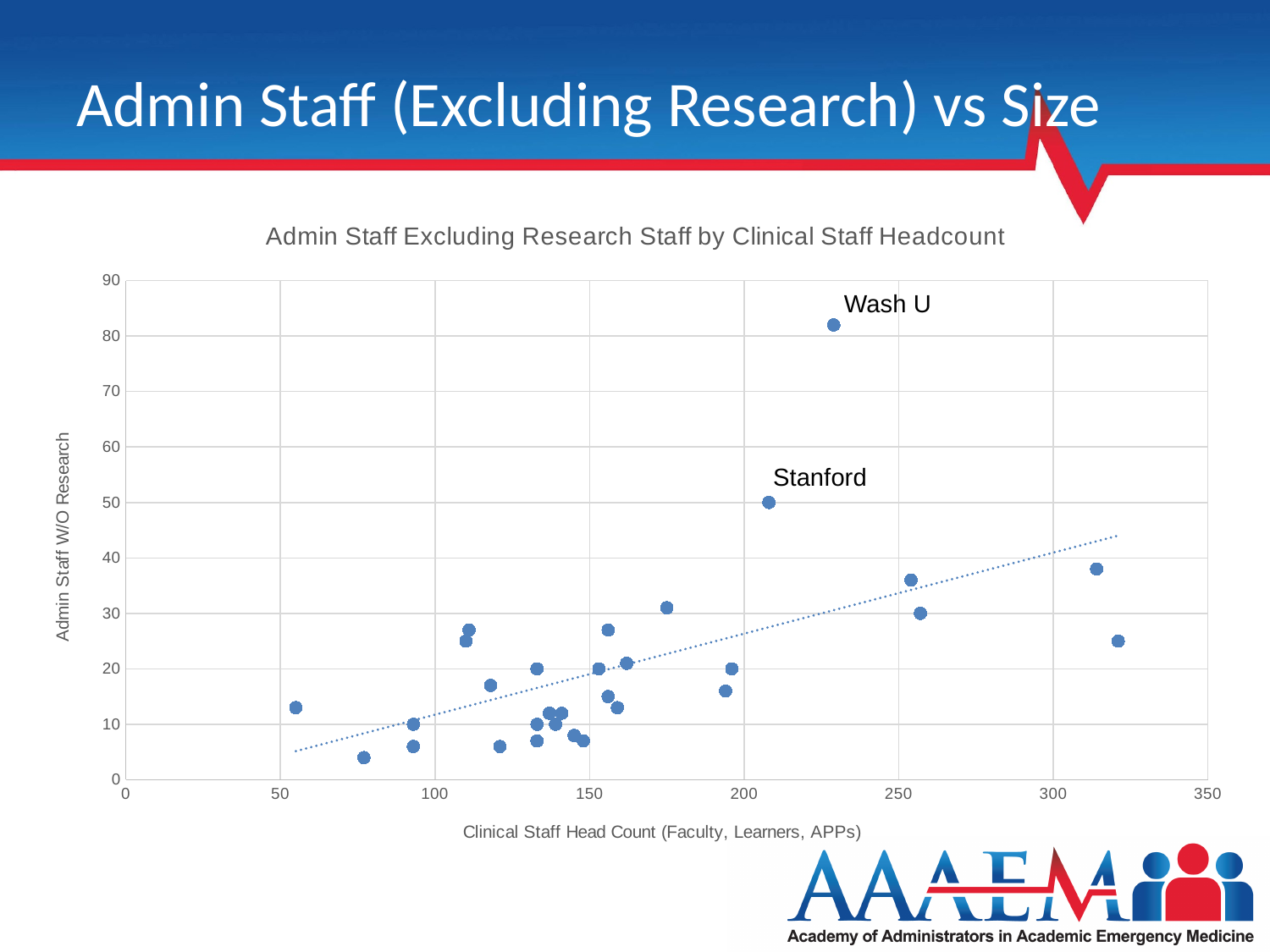
What kind of chart is shown on the slide? scatter chart What is the title of the chart? Admin Staff Excluding Research Staff by Clinical Staff Headcount Is the admin staff value for Stanford greater or less than 60? less Does the dotted trend line rise or fall as clinical staff headcount increases? rise Is the admin staff value for Wash U greater or less than 80? greater Is the clinical staff headcount for Stanford greater or less than 250? less Which labeled institution has the highest admin staff value on the chart? Wash U What is the maximum value shown on the y axis? 90 What is the label of the x axis? Clinical Staff Head Count (Faculty, Learners, APPs) How many data points on the chart are labeled with an institution name? 2 Which has a higher admin staff value, Wash U or Stanford? Wash U